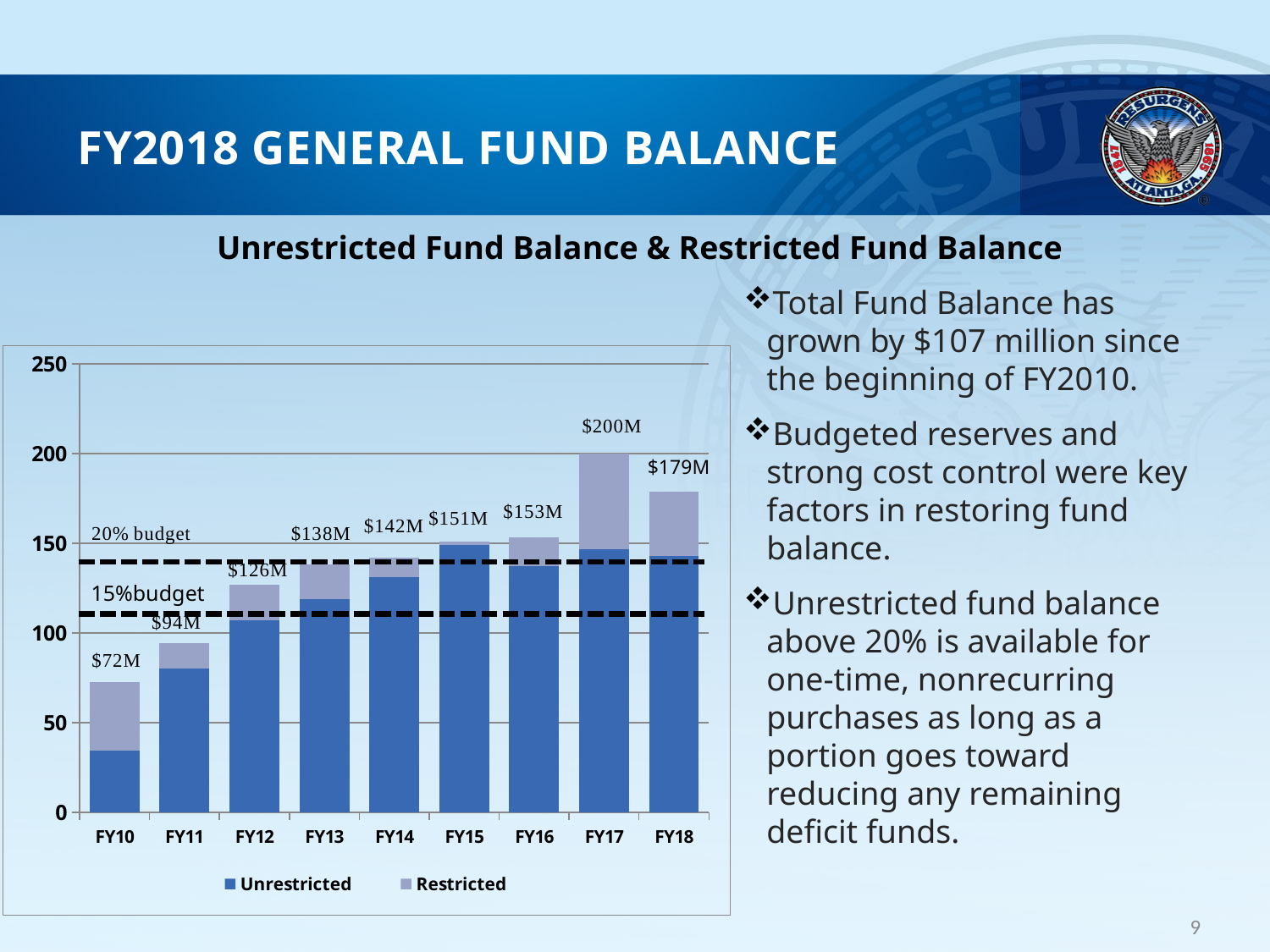
What is the total fund balance labeled for FY17? $200M What is the total fund balance labeled for FY10? $72M What is the difference between the total fund balance in FY17 and FY18? $21M How many fiscal years are shown on the x axis? 9 Which fiscal year has the lowest total fund balance? FY10 What is the total fund balance labeled for FY14? $142M What kind of chart is shown on the slide? Stacked bar chart Is the Unrestricted value for FY10 greater or less than 50? less Which fiscal year has the highest total fund balance? FY17 How many series does the legend list? 2 Does the total fund balance rise or fall from FY10 to FY17? Rise Which is larger, the total fund balance in FY12 or FY13? FY13